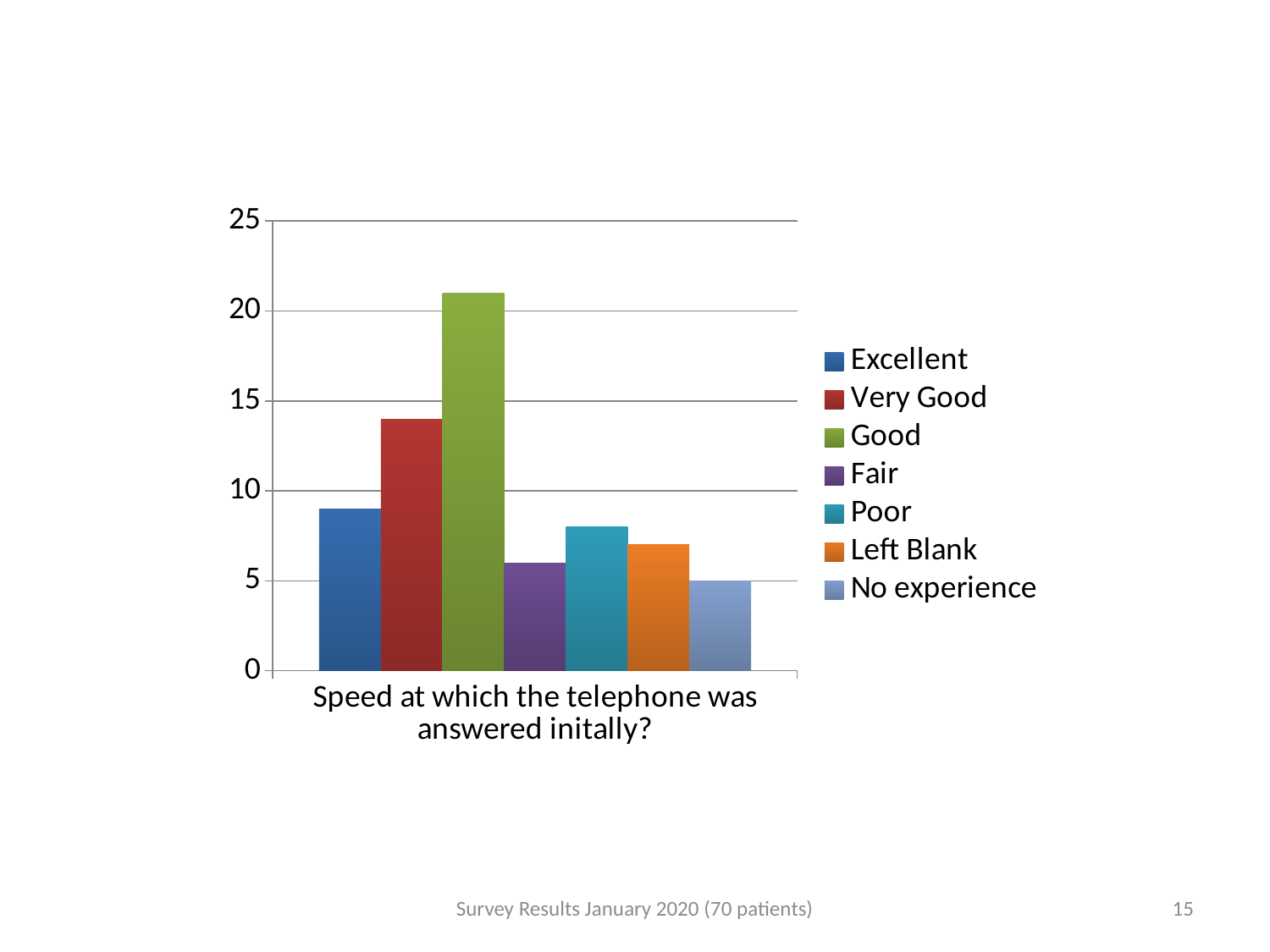
Which is larger, the value for Poor or the value for Fair? Poor Which is larger, the value for Very Good or the value for Excellent? Very Good Is the value for Good greater or less than 20? greater How many entries does the legend list? 7 What is the category label shown under the bars on the x axis? Speed at which the telephone was answered initally? What kind of chart is shown on the slide? bar chart Is the value for Very Good greater or less than 15? less Which response has the lowest bar? No experience Is the value for Excellent greater or less than 10? less Which response has the highest bar? Good What is the value for No experience? 5